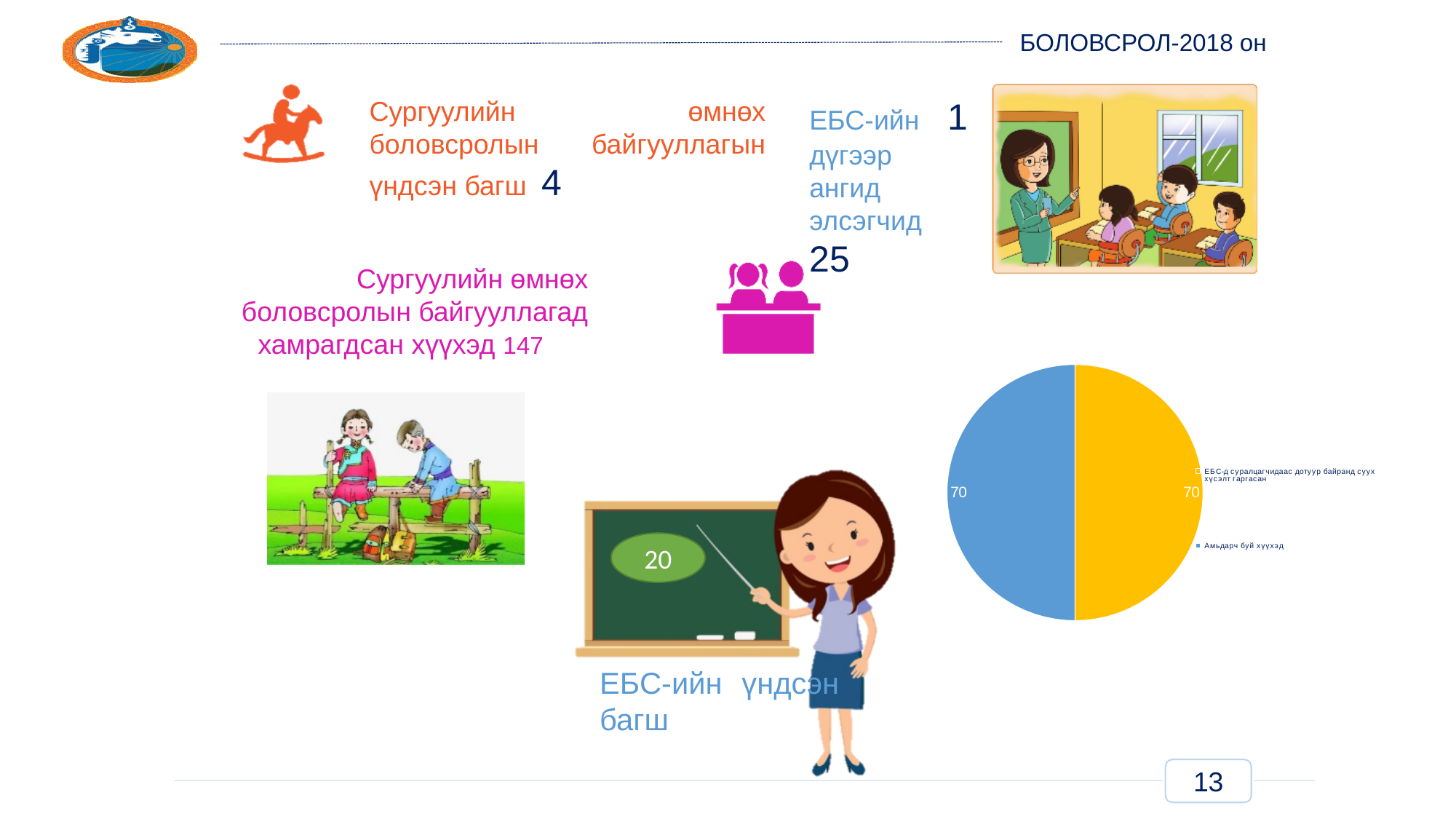
What colour is the "ЕБС-д суралцагчидаас дотуур байранд суух хүсэлт гаргасан" slice in the pie chart? yellow Is the value for "Амьдарч буй хүүхэд" larger than, smaller than, or equal to the value for "ЕБС-д суралцагчидаас дотуур байранд суух хүсэлт гаргасан" in the pie chart? equal What is the value of the slice labelled "Амьдарч буй хүүхэд" in the pie chart? 70 What is the difference between the two slice values in the pie chart? 0 How many slices does the pie chart have? 2 What kind of chart is shown on the slide? pie chart How many entries does the legend of the pie chart list? 2 What is the value of the slice labelled "ЕБС-д суралцагчидаас дотуур байранд суух хүсэлт гаргасан" in the pie chart? 70 What share of the pie chart does the "Амьдарч буй хүүхэд" slice represent? 50% What colour is the "Амьдарч буй хүүхэд" slice in the pie chart? blue What is the total of the two slice values in the pie chart? 140